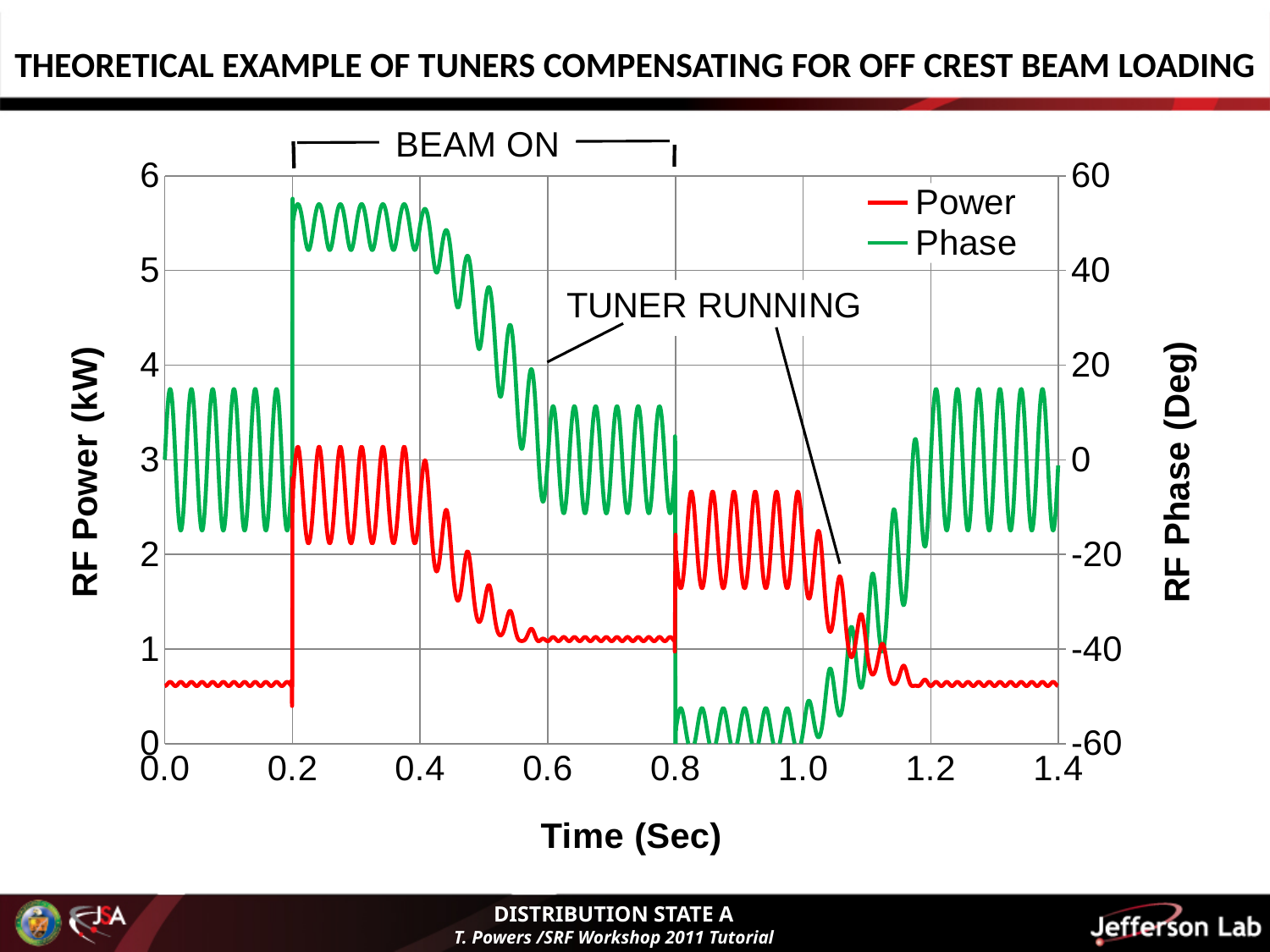
What colour is the Phase line in the chart? green Is the Power value at time 1.3 sec greater or less than 1 kW? less Which two series are listed in the chart legend? Power and Phase Is the Power value at time 0.1 sec greater or less than 1 kW? less Is the Power value at time 0.7 sec greater or less than 2 kW? less Does the Phase line rise or fall between 1.0 sec and 1.2 sec? rise What kind of chart is shown on the slide? line chart Does the Power line rise or fall between 0.4 sec and 0.6 sec? fall How many series does the chart legend list? 2